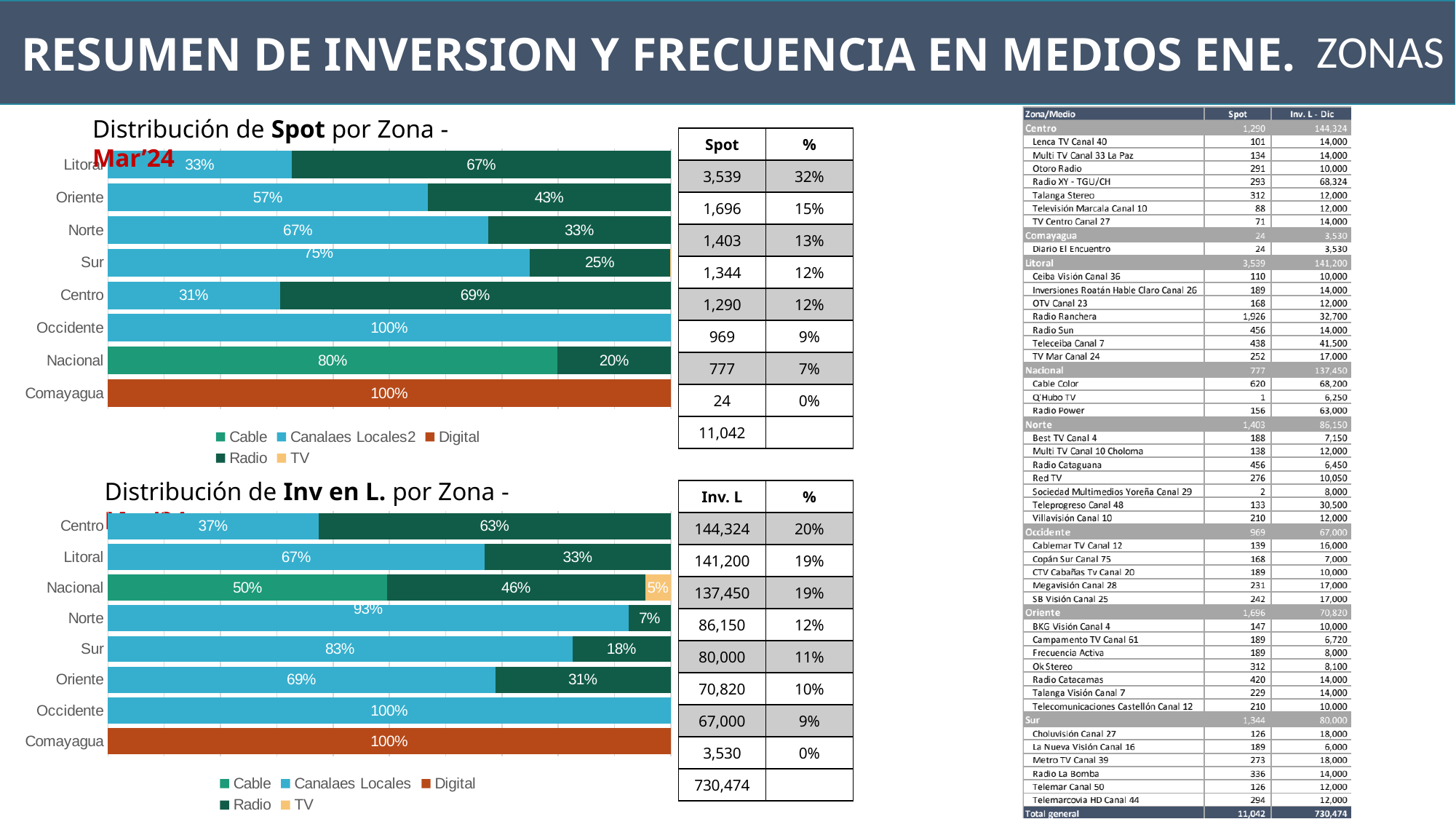
In the 'Distribución de Spot por Zona' chart, what is the Canales Locales share for Sur? 75% In the 'Distribución de Inv en L. por Zona' chart, what is the TV share for Nacional? 5% In the 'Distribución de Spot por Zona' chart, which zone has the highest Radio share? Centro How many series does the legend of the 'Distribución de Inv en L. por Zona' chart list? 5 What type of chart is the 'Distribución de Spot por Zona' chart? Stacked bar chart In the 'Distribución de Spot por Zona' chart, what is the difference between the Radio share and the Canales Locales share for Oriente? 14% In the 'Distribución de Inv en L. por Zona' chart, what is the Radio share for Centro? 63% In the 'Distribución de Spot por Zona' chart, what is the Cable share for Nacional? 80% In the 'Distribución de Inv en L. por Zona' chart, which zone has the lowest Radio share among zones with a Radio segment? Norte In the 'Distribución de Spot por Zona' chart, how many zones are shown? 8 In the 'Distribución de Spot por Zona' chart, what is the Radio share for Litoral? 67% In the 'Distribución de Inv en L. por Zona' chart, is the Canales Locales share larger for Norte or for Sur? Norte